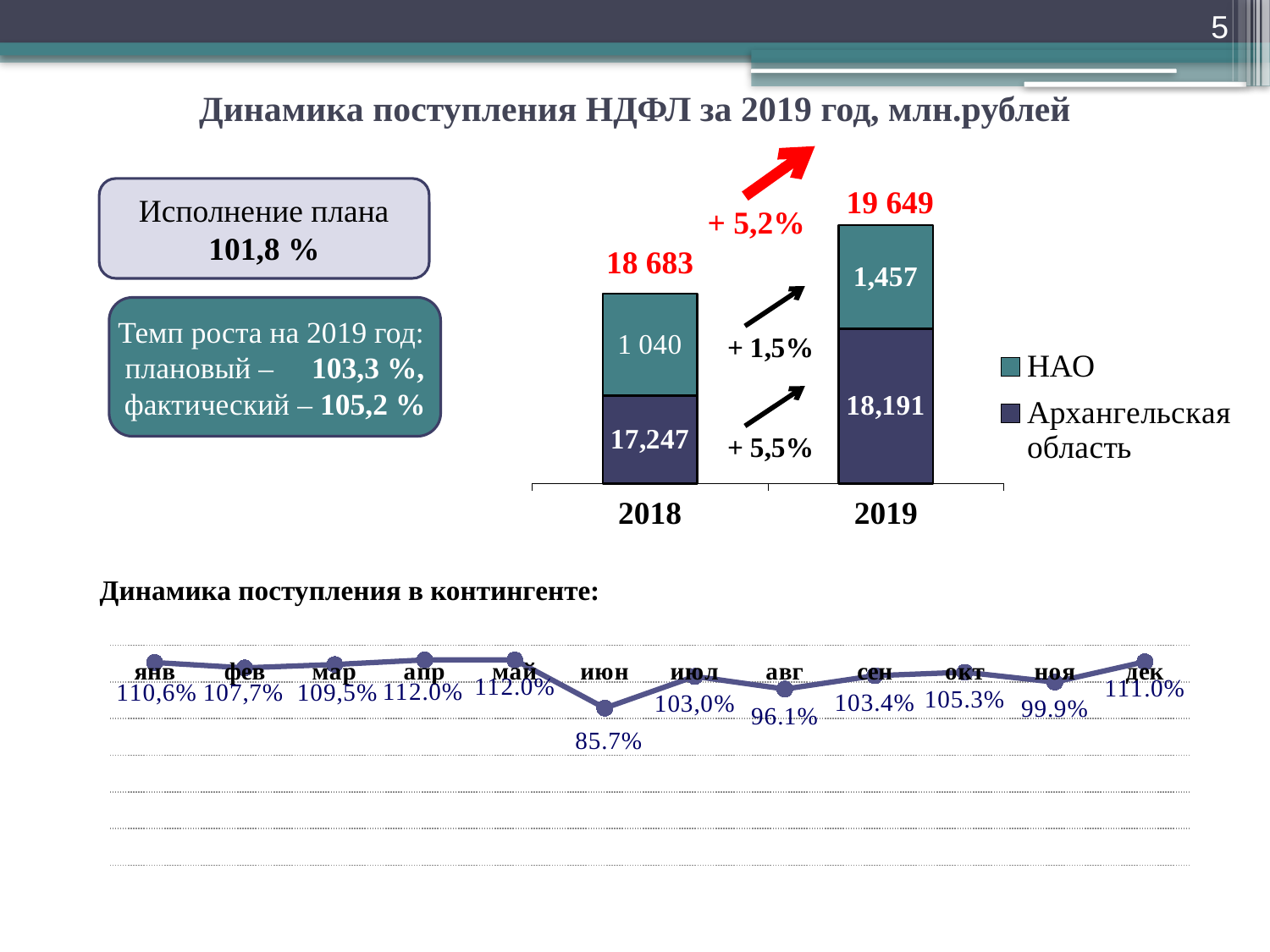
In the stacked bar chart, what is the difference between the Архангельская область values for 2019 and 2018? 944 In the line chart 'Динамика поступления в контингенте', what is the value for июн? 85.7% In the stacked bar chart, which year has the larger value for Архангельская область, 2018 or 2019? 2019 In the stacked bar chart, what is the value for Архангельская область in 2018? 17,247 In the stacked bar chart, what is the total shown above the 2018 bar? 18 683 In the stacked bar chart, how many series does the legend list? 2 In the line chart 'Динамика поступления в контингенте', how many months are plotted? 12 What kind of chart is the chart titled 'Динамика поступления в контингенте'? line chart In the stacked bar chart, what is the value for НАО in 2019? 1,457 In the stacked bar chart, what is the total shown above the 2019 bar? 19 649 In the line chart 'Динамика поступления в контингенте', which month has the lowest value? июн In the line chart 'Динамика поступления в контингенте', which is larger, the value for авг or the value for сен? сен